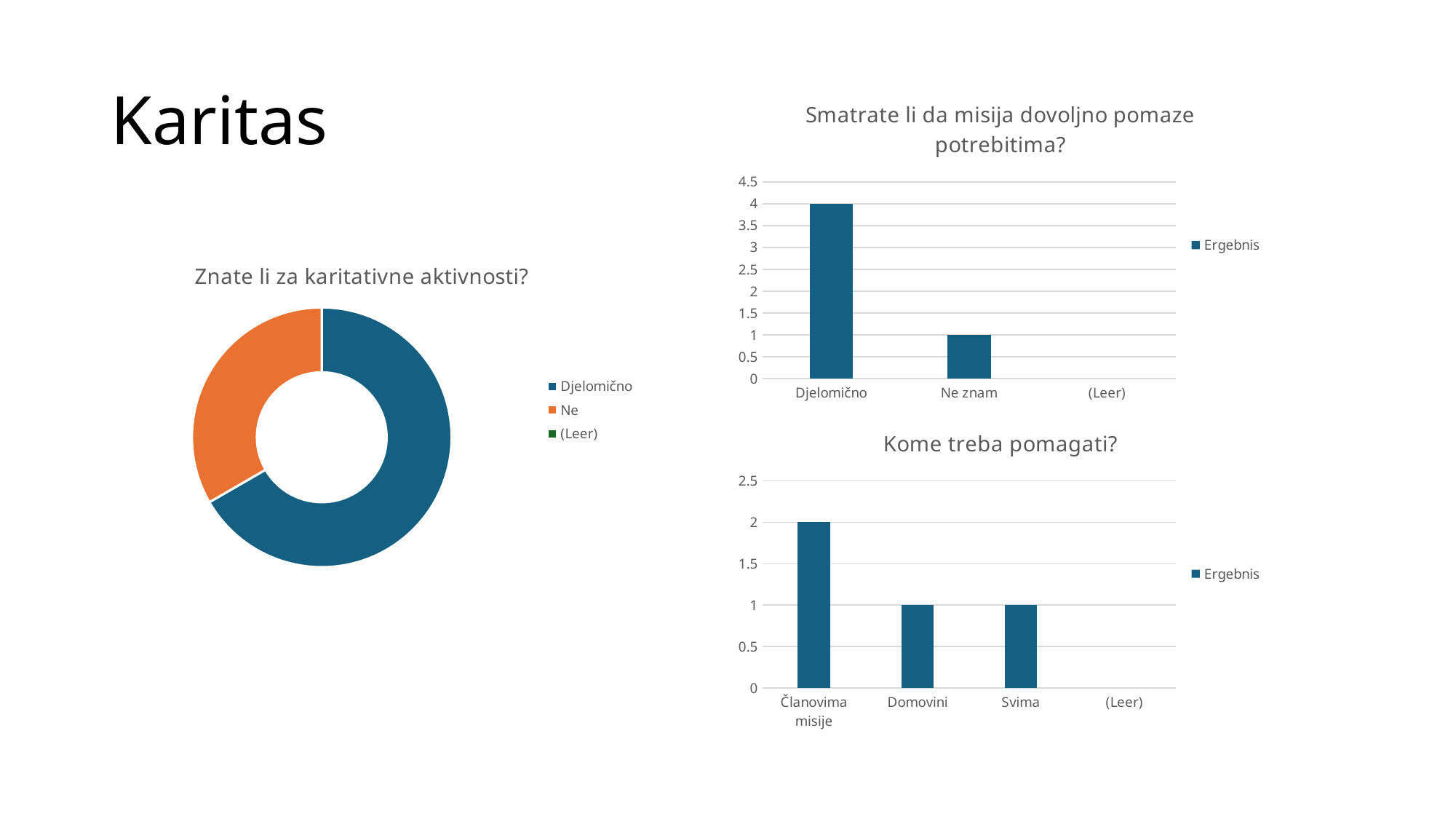
In the chart titled "Smatrate li da misija dovoljno pomaze potrebitima?", what is the difference between the values for Djelomično and Ne znam? 3 In the chart titled "Smatrate li da misija dovoljno pomaze potrebitima?", which category has the highest value? Djelomično In the chart titled "Znate li za karitativne aktivnosti?", how many entries does the legend list? 3 In the chart titled "Smatrate li da misija dovoljno pomaze potrebitima?", what is the value for Djelomično? 4 In the chart titled "Smatrate li da misija dovoljno pomaze potrebitima?", what is the value for Ne znam? 1 In the chart titled "Znate li za karitativne aktivnosti?", which is larger, the slice for Djelomično or the slice for Ne? Djelomično In the chart titled "Kome treba pomagati?", what is the value for Domovini? 1 In the chart titled "Kome treba pomagati?", which is larger, the value for Članovima misije or the value for Svima? Članovima misije In the chart titled "Kome treba pomagati?", what is the value for Članovima misije? 2 In the chart titled "Kome treba pomagati?", which category has the highest value? Članovima misije What kind of chart is the chart titled "Znate li za karitativne aktivnosti?"? Doughnut chart In the chart titled "Kome treba pomagati?", how many categories are shown on the x axis? 4